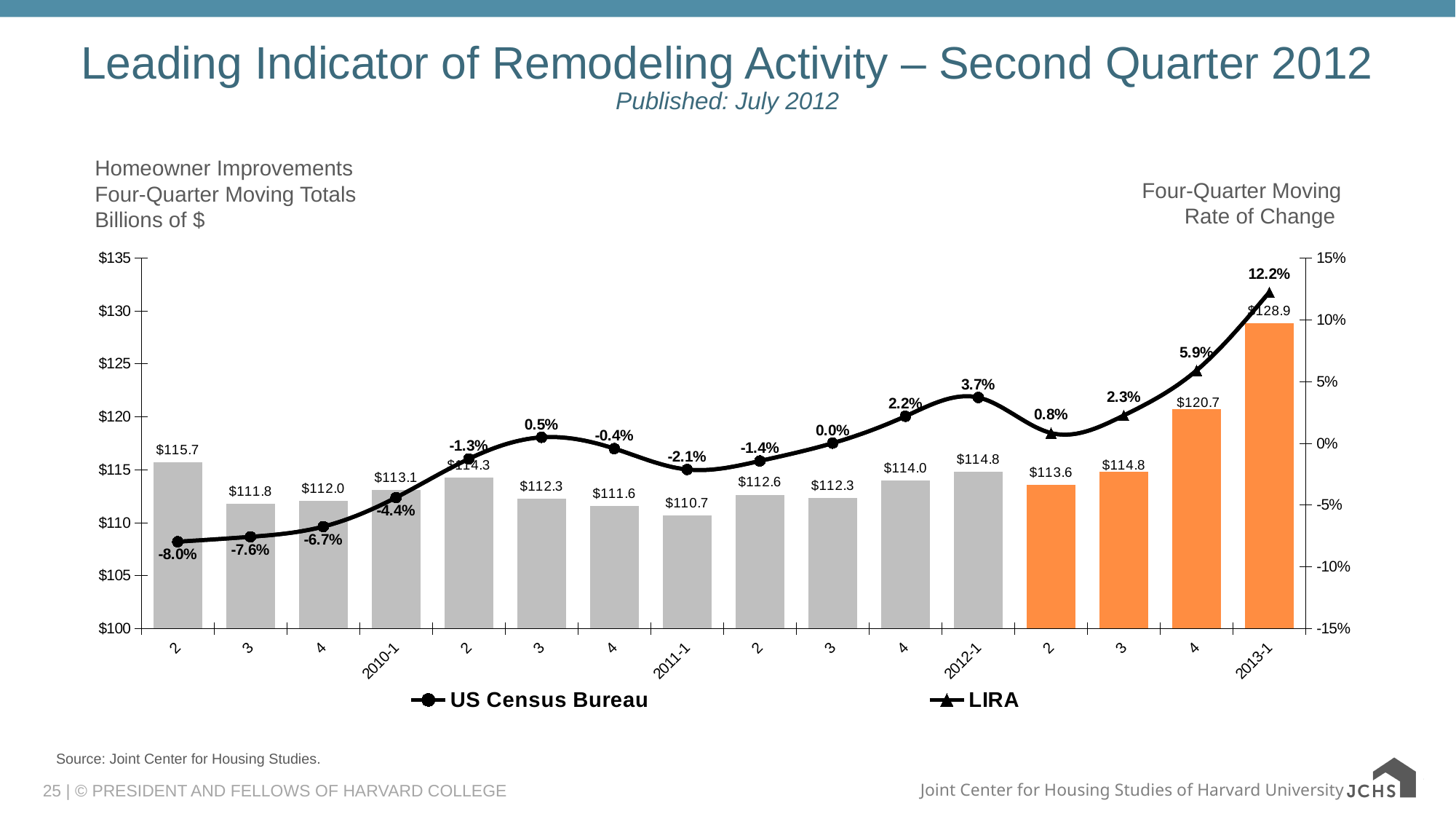
What is the value of the bar for 2013-1? $128.9 What are the two series named in the legend? US Census Bureau and LIRA How many series does the legend list? 2 Which quarter has the lowest bar value? 2011-1 What is the four-quarter moving rate of change shown for 2012-1? 3.7% Which quarter has the highest bar value? 2013-1 What is the four-quarter moving rate of change shown for 2013-1? 12.2% How many bars are plotted on the chart? 16 Does the rate of change line rise or fall from 2012-1's following quarter (0.8%) through 2013-1? rise What is the value of the bar for 2011-1? $110.7 Which is larger, the bar value for 2010-1 or for 2011-1? 2010-1 What is the difference between the bar value for 2013-1 ($128.9) and the bar immediately before it ($120.7)? $8.2